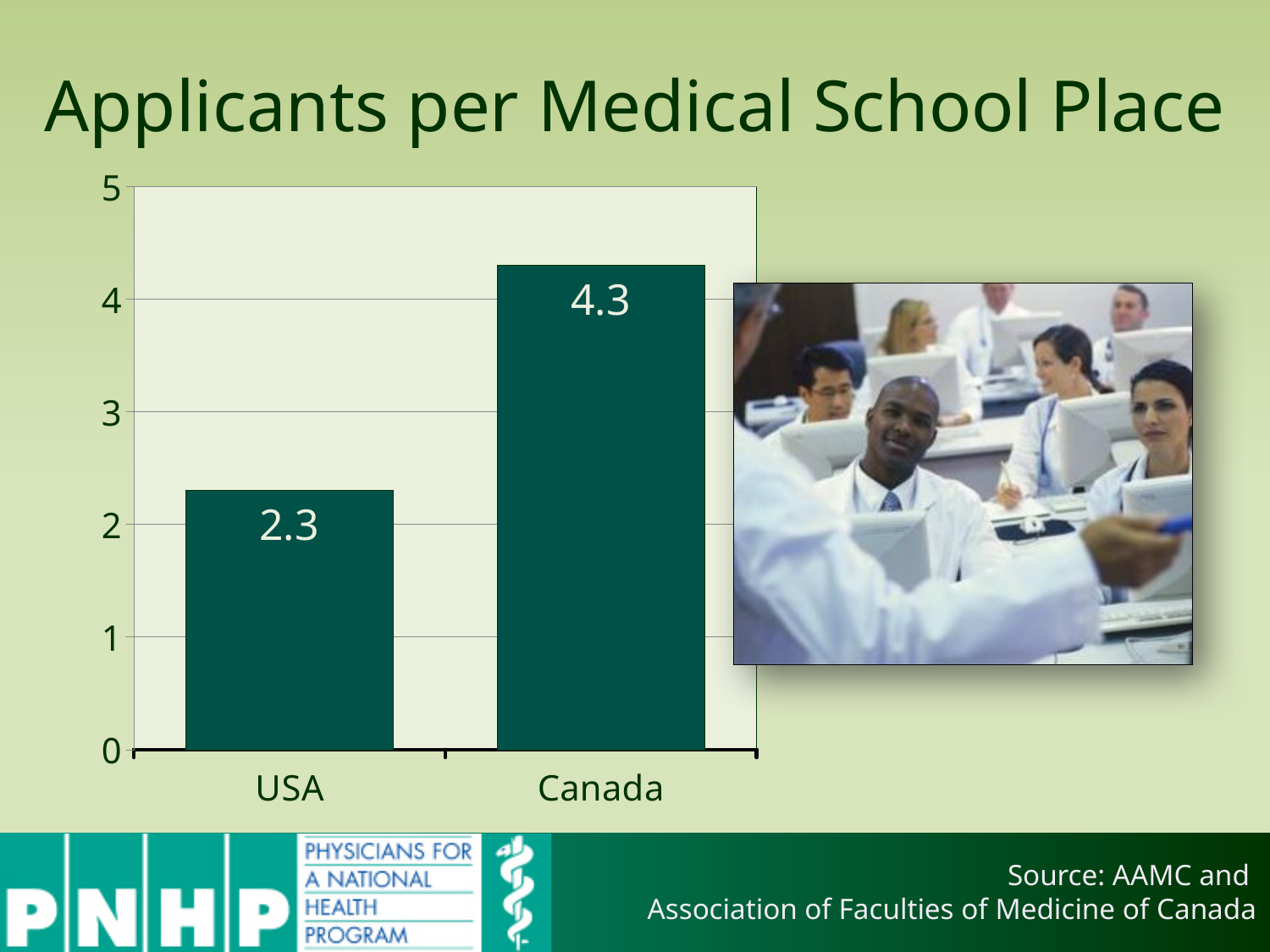
Is the value for Canada greater or less than the value for the USA? greater Which country has the lower number of applicants per medical school place? USA What type of chart is shown on the slide? bar chart What is the difference between Canada's and the USA's applicants per medical school place? 2.0 What is the number of applicants per medical school place for the USA? 2.3 What is the title of the chart? Applicants per Medical School Place Is the value for the USA greater or less than 3? less Is the value for Canada greater or less than 4? greater Which country has the higher number of applicants per medical school place? Canada How many countries are shown in the chart? 2 What is the maximum value shown on the vertical axis? 5 What is the number of applicants per medical school place for Canada? 4.3